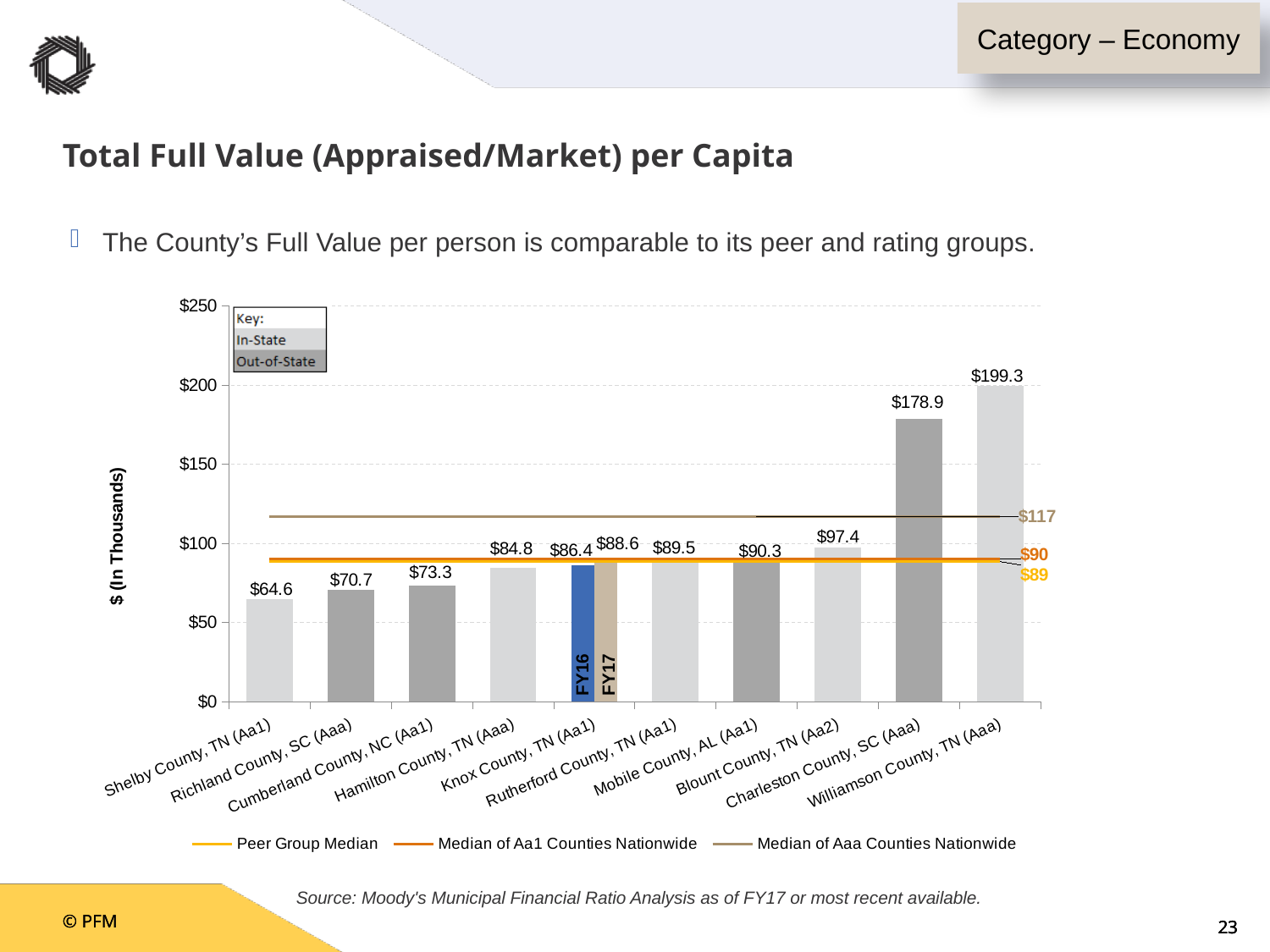
What is the difference between the values for Williamson County, TN (Aaa) and Charleston County, SC (Aaa)? $20.4 By how much did Knox County, TN (Aa1) increase from FY16 to FY17? $2.2 Which is larger, the value for Blount County, TN (Aa2) or Mobile County, AL (Aa1)? Blount County, TN (Aa2) What is the FY17 value for Knox County, TN (Aa1)? $88.6 Which county has the highest Total Full Value per Capita? Williamson County, TN (Aaa) What is the value of the Median of Aaa Counties Nationwide line? $117 What is the Total Full Value per Capita for Williamson County, TN (Aaa)? $199.3 How many series does the legend below the chart list? 3 What kind of chart is used on this slide? Bar chart Which county has the lowest Total Full Value per Capita? Shelby County, TN (Aa1) How many counties are shown on the x axis of the chart? 10 What is the value shown for Shelby County, TN (Aa1)? $64.6